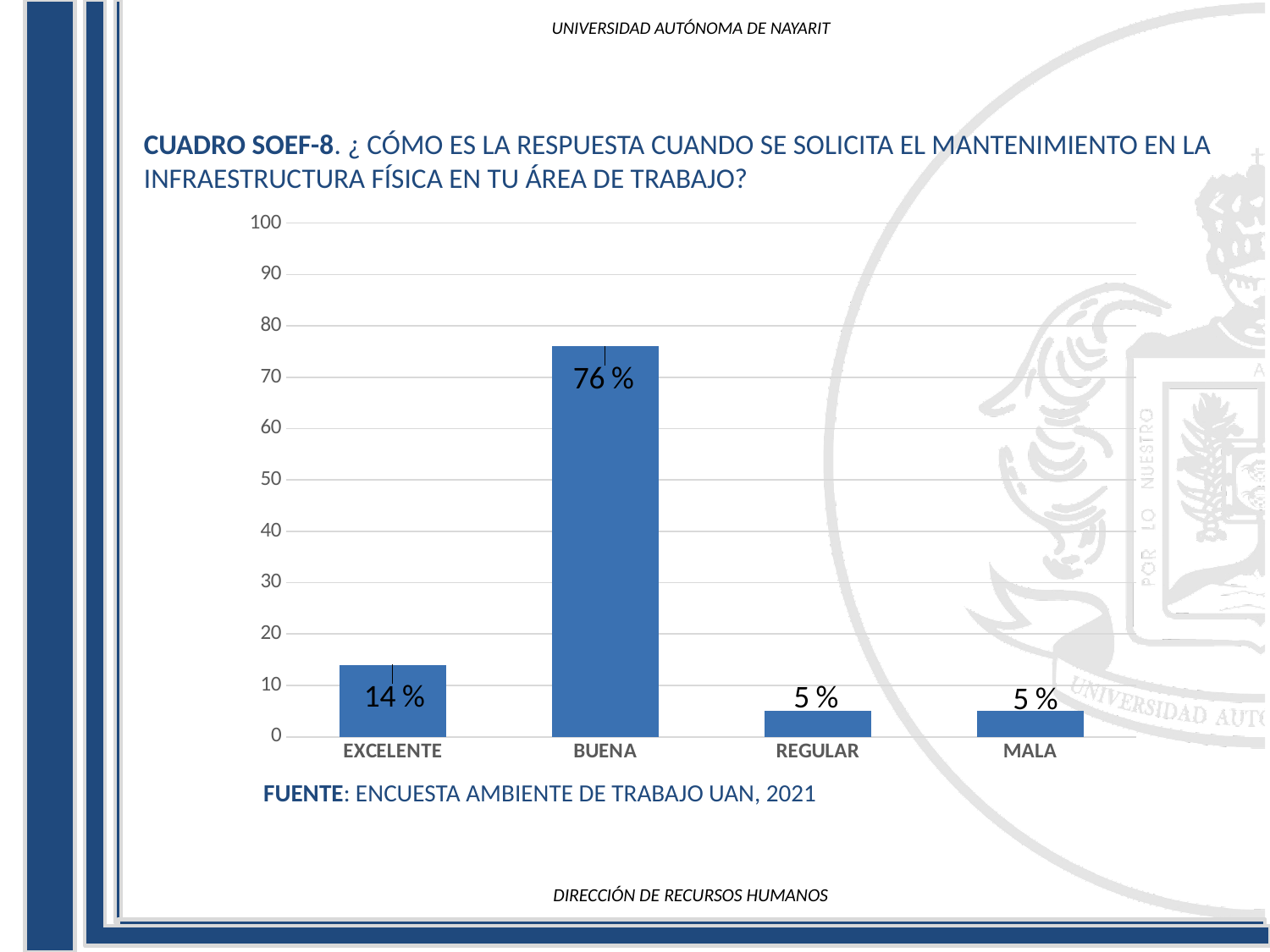
What source is cited below the chart? ENCUESTA AMBIENTE DE TRABAJO UAN, 2021 Is the value for BUENA greater or less than 70? greater What is the value for BUENA? 76 % What is the difference between the values for BUENA and EXCELENTE? 62 % What is the difference between the values for EXCELENTE and REGULAR? 9 % What is the value for MALA? 5 % Which is larger, the value for EXCELENTE or the value for MALA? EXCELENTE What kind of chart is shown on the slide? bar chart Which category has the highest value? BUENA What is the value for EXCELENTE? 14 % What is the value for REGULAR? 5 % How many categories are shown on the x axis? 4